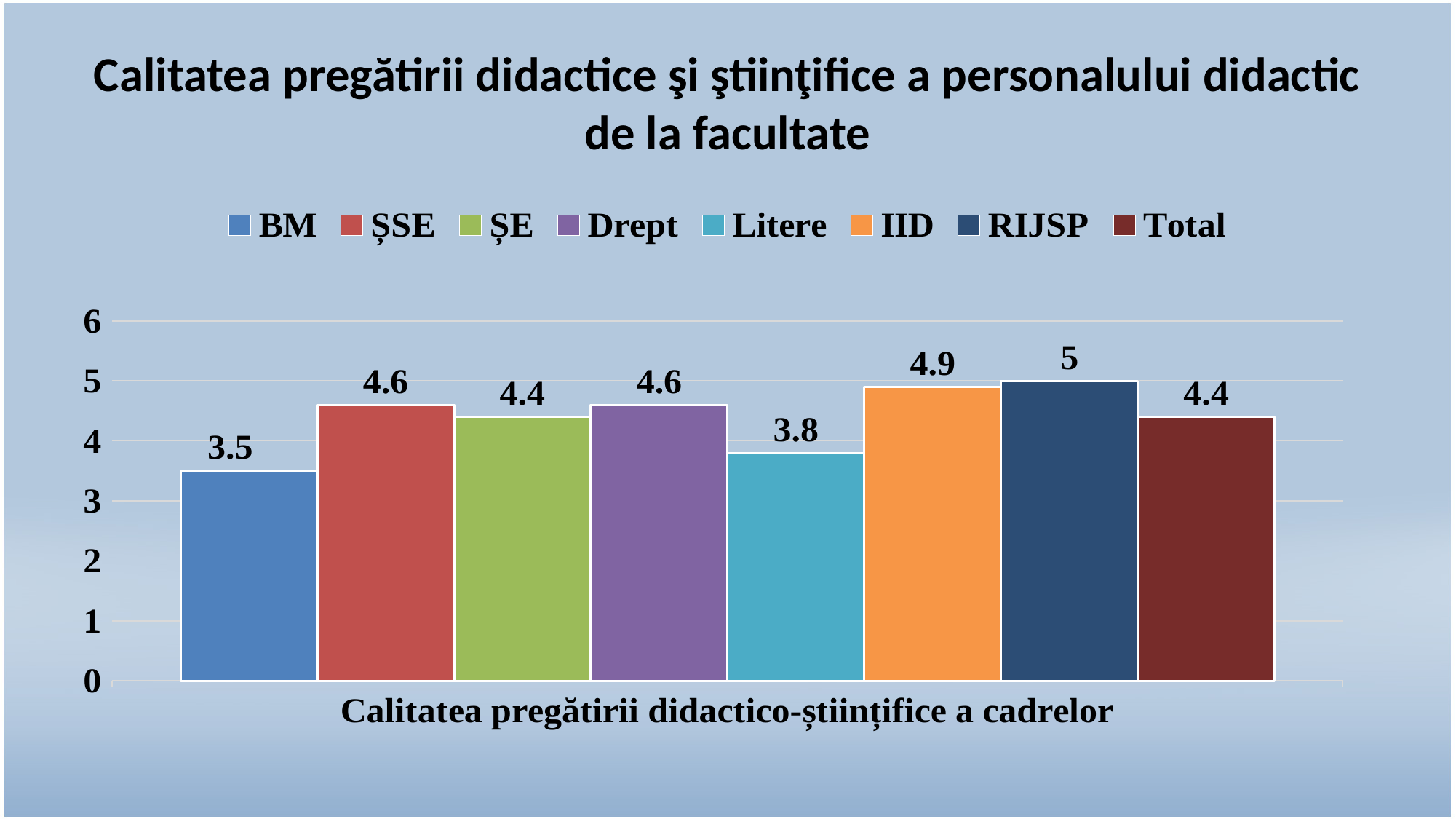
What is the value for Total? 4.4 What is the value for IID? 4.9 Which series has the highest value? RIJSP What is the label on the x axis of the chart? Calitatea pregătirii didactico-științifice a cadrelor What is the value for BM? 3.5 How many series does the legend list? 8 What is the difference between the values for RIJSP and BM? 1.5 Which series has the lowest value? BM What is the difference between the values for IID and Litere? 1.1 What kind of chart is shown on the slide? Bar chart Which is larger, the value for ȘSE or the value for ȘE? ȘSE What is the value for Litere? 3.8